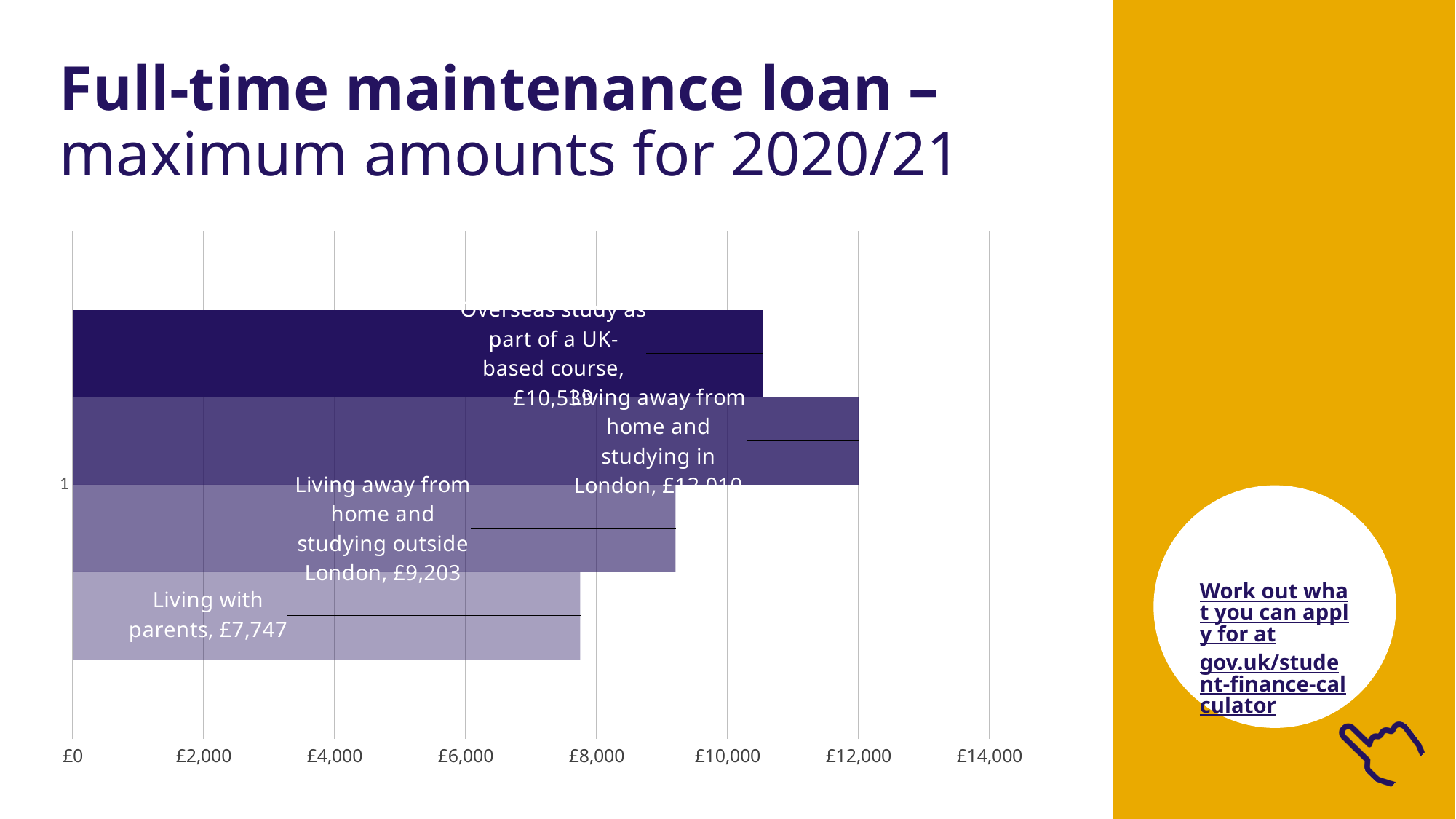
Which is larger: the maximum loan for living with parents or for living away from home and studying outside London? Living away from home and studying outside London Which category has the highest maximum loan amount? Living away from home and studying in London How many categories of maintenance loan are shown in the chart? 4 Which category has the lowest maximum loan amount? Living with parents What is the maximum full-time maintenance loan for a student living with parents? £7,747 What kind of chart is shown on the slide? Bar chart What is the maximum loan for a student living away from home and studying outside London? £9,203 What is the title of the slide? Full-time maintenance loan – maximum amounts for 2020/21 Is the value for overseas study as part of a UK-based course greater or less than £10,000? greater How much more is the maximum loan for living away from home and studying outside London than for living with parents? £1,456 Is the value for living away from home and studying in London greater or less than £10,000? greater Is the value for overseas study as part of a UK-based course greater or less than £12,000? less